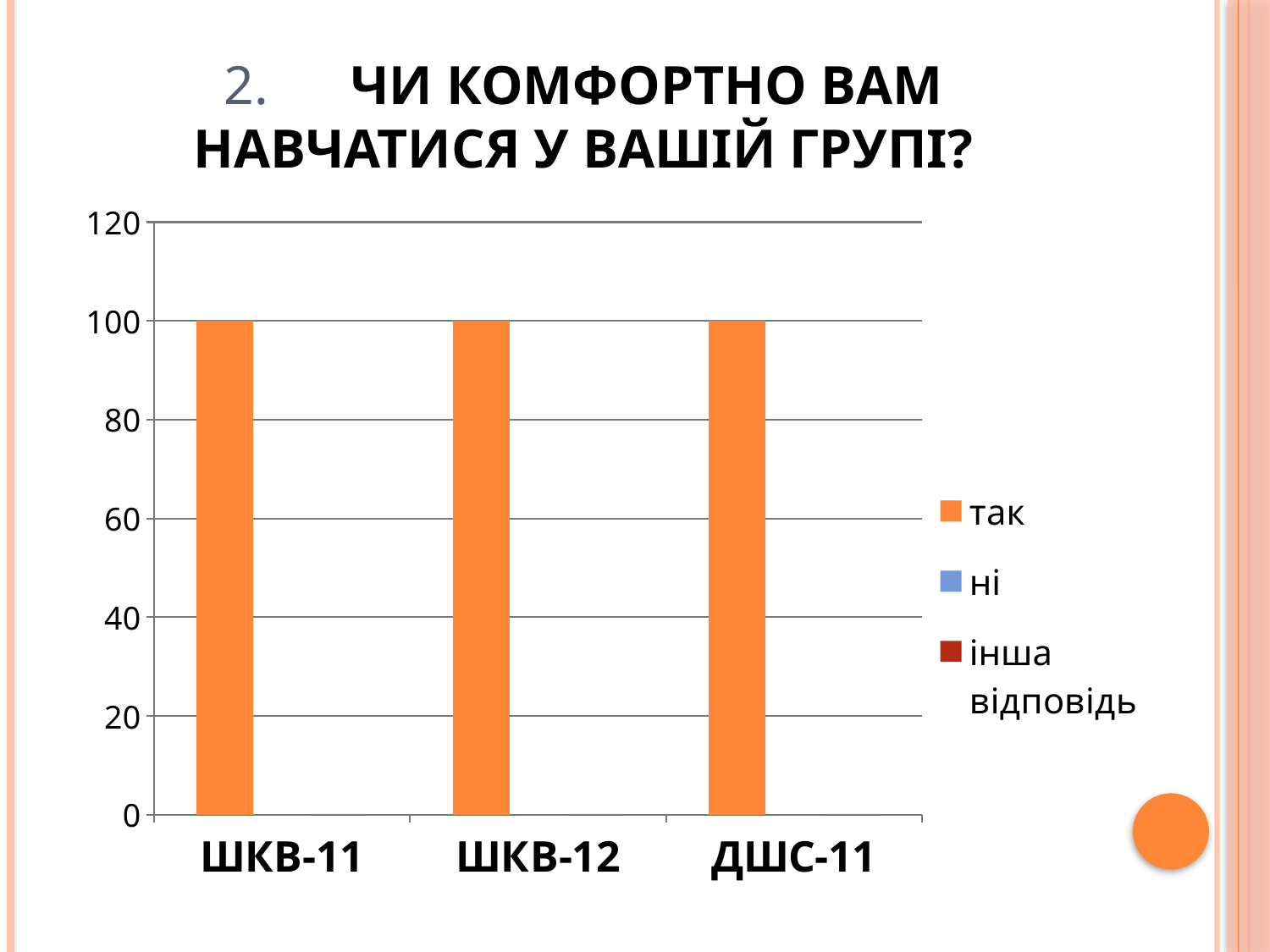
What is the value of the "так" bar for ШКВ-11? 100 Do the "так" values rise, fall, or stay the same across the groups from ШКВ-11 to ДШС-11? stay the same Is the "так" value for ШКВ-12 greater or less than 80? greater What is the difference between the "так" values for ШКВ-11 and ДШС-11? 0 What is the value of the "так" bar for ДШС-11? 100 What kind of chart is shown on the slide? bar chart What is the highest value shown on the vertical axis? 120 How many groups (categories) are shown on the x axis? 3 What is the value of the "так" bar for ШКВ-12? 100 Which legend entry is shown in orange? так Is the "так" value for ДШС-11 greater or less than 120? less How many series does the legend list? 3